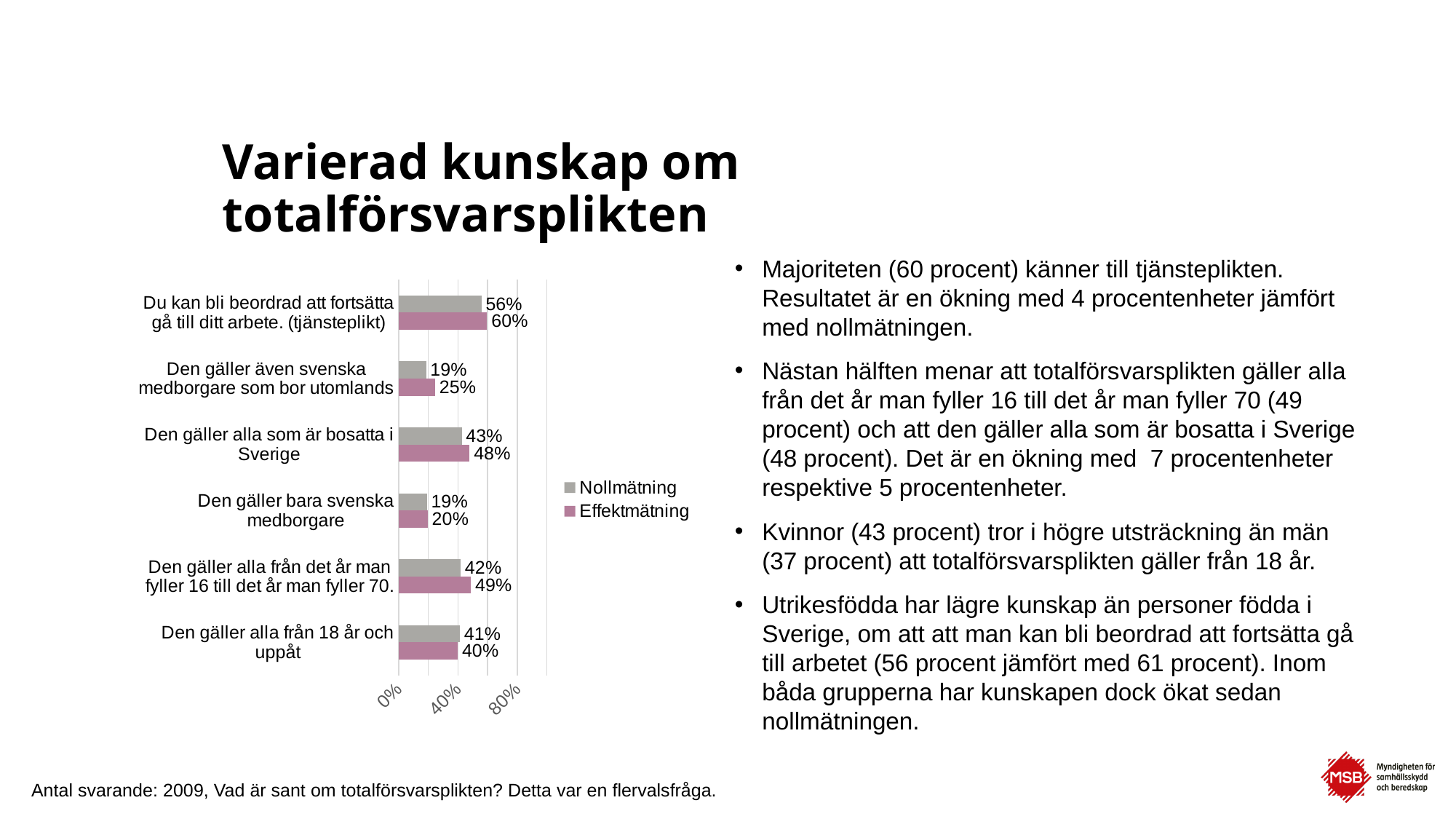
Which category has the highest Effektmätning value? Du kan bli beordrad att fortsätta gå till ditt arbete. (tjänsteplikt) What is the Effektmätning value for "Du kan bli beordrad att fortsätta gå till ditt arbete. (tjänsteplikt)"? 60% How many categories are shown in the chart? 6 How many series does the legend list? 2 What is the difference between the Effektmätning and Nollmätning values for "Den gäller alla från det år man fyller 16 till det år man fyller 70."? 7% Is the Effektmätning value for "Den gäller alla som är bosatta i Sverige" greater or less than 40%? greater What kind of chart is shown on the slide? Bar chart Which category has the lowest Effektmätning value? Den gäller bara svenska medborgare What is the Effektmätning value for "Den gäller alla från det år man fyller 16 till det år man fyller 70."? 49% Which colour represents the Effektmätning series in the chart? Pink/purple What is the Nollmätning value for "Den gäller även svenska medborgare som bor utomlands"? 19% For "Den gäller alla från 18 år och uppåt", which is larger: the Nollmätning value or the Effektmätning value? Nollmätning